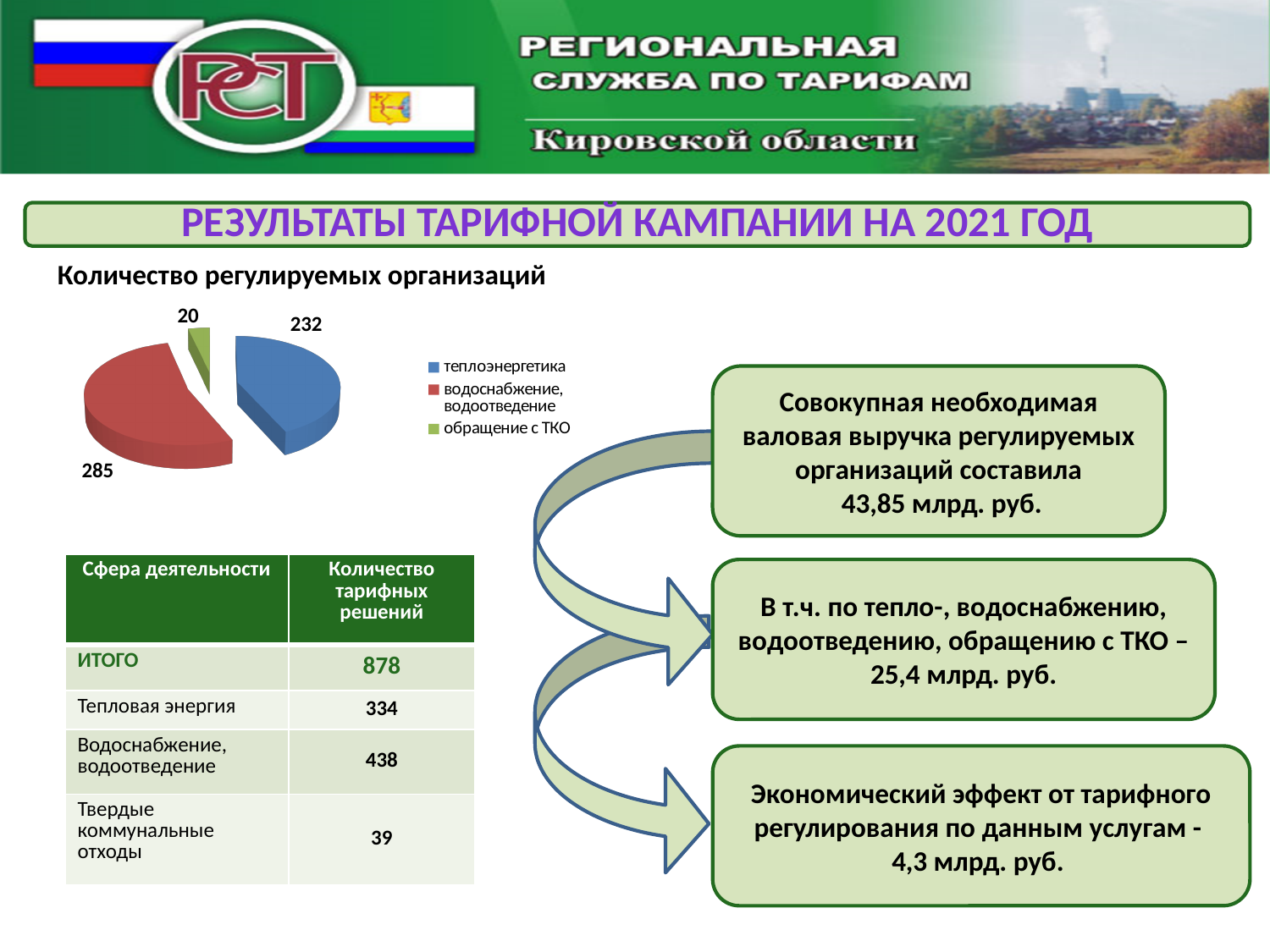
Which category has the smallest slice in the pie chart? обращение с ТКО What is the sum of all the values shown in the pie chart? 537 In the pie chart, what is the value for обращение с ТКО? 20 How many slices does the pie chart have? 3 In the pie chart, what is the value for теплоэнергетика? 232 In the pie chart, what is the value for водоснабжение, водоотведение? 285 Which category has the largest slice in the pie chart? водоснабжение, водоотведение In the pie chart, what is the difference between the values for водоснабжение, водоотведение and теплоэнергетика? 53 In the pie chart, which is larger: теплоэнергетика or обращение с ТКО? теплоэнергетика What colour is the теплоэнергетика slice in the pie chart? blue What kind of chart is shown under the heading "Количество регулируемых организаций"? pie chart In the pie chart, how much larger is the value for теплоэнергетика than the value for обращение с ТКО? 212